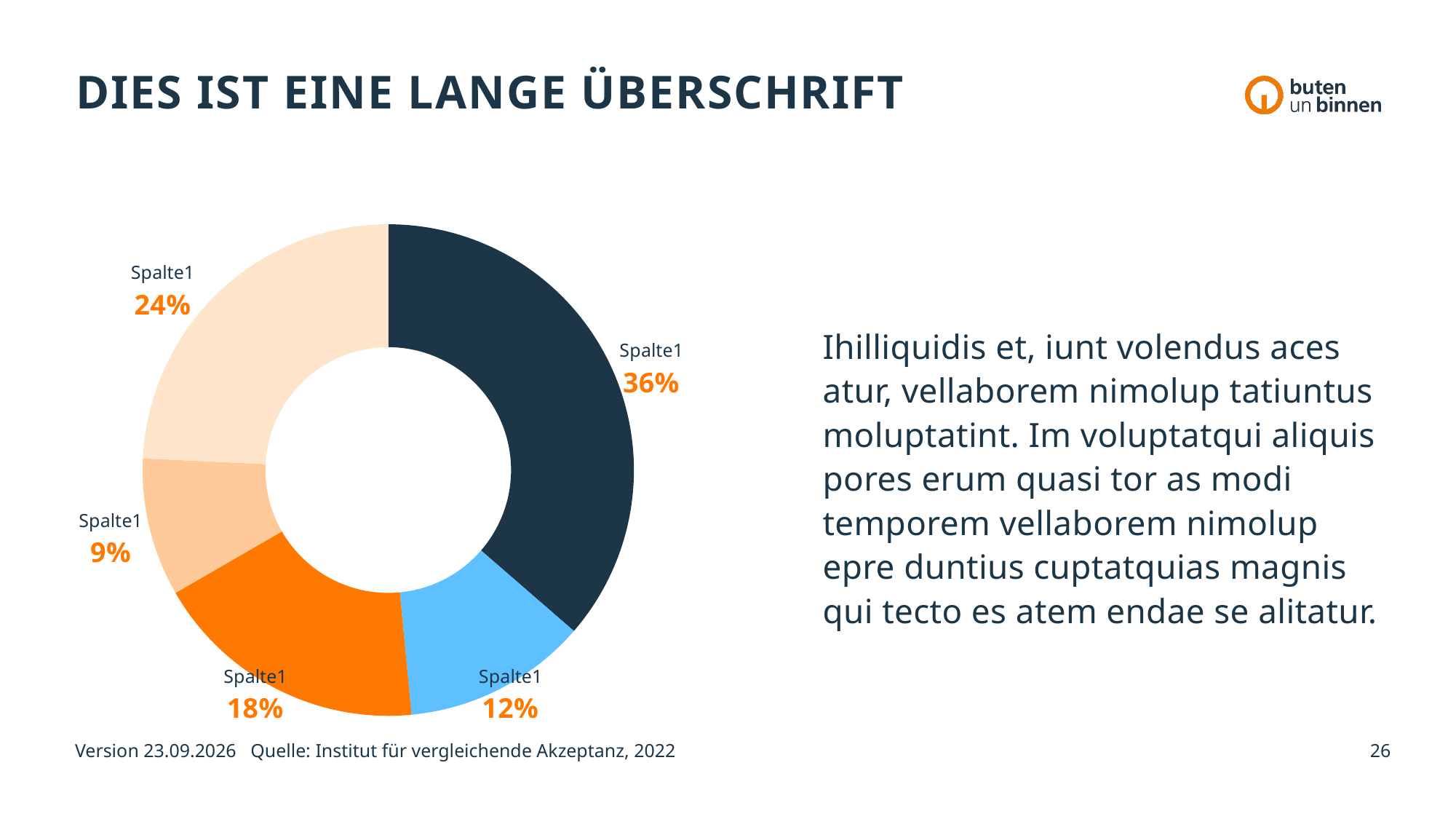
How many slices does the pie chart have? 5 What kind of chart is shown on the slide? doughnut chart What percentage is shown for the pale peach slice at the top left of the pie chart? 24% What percentage is shown for the bright orange slice of the pie chart? 18% What source is cited below the chart? Institut für vergleichende Akzeptanz, 2022 What percentage is shown for the smallest slice of the pie chart? 9% What is the difference in percentage points between the dark navy slice (36%) and the light blue slice (12%)? 24 What percentage is shown for the light blue slice of the pie chart? 12% What label is used for every slice of the pie chart? Spalte1 Which is larger in the pie chart: the bright orange slice or the light blue slice? the bright orange slice What percentage is shown for the dark navy slice of the pie chart? 36% Which slice of the pie chart is the largest? the dark navy slice (36%)